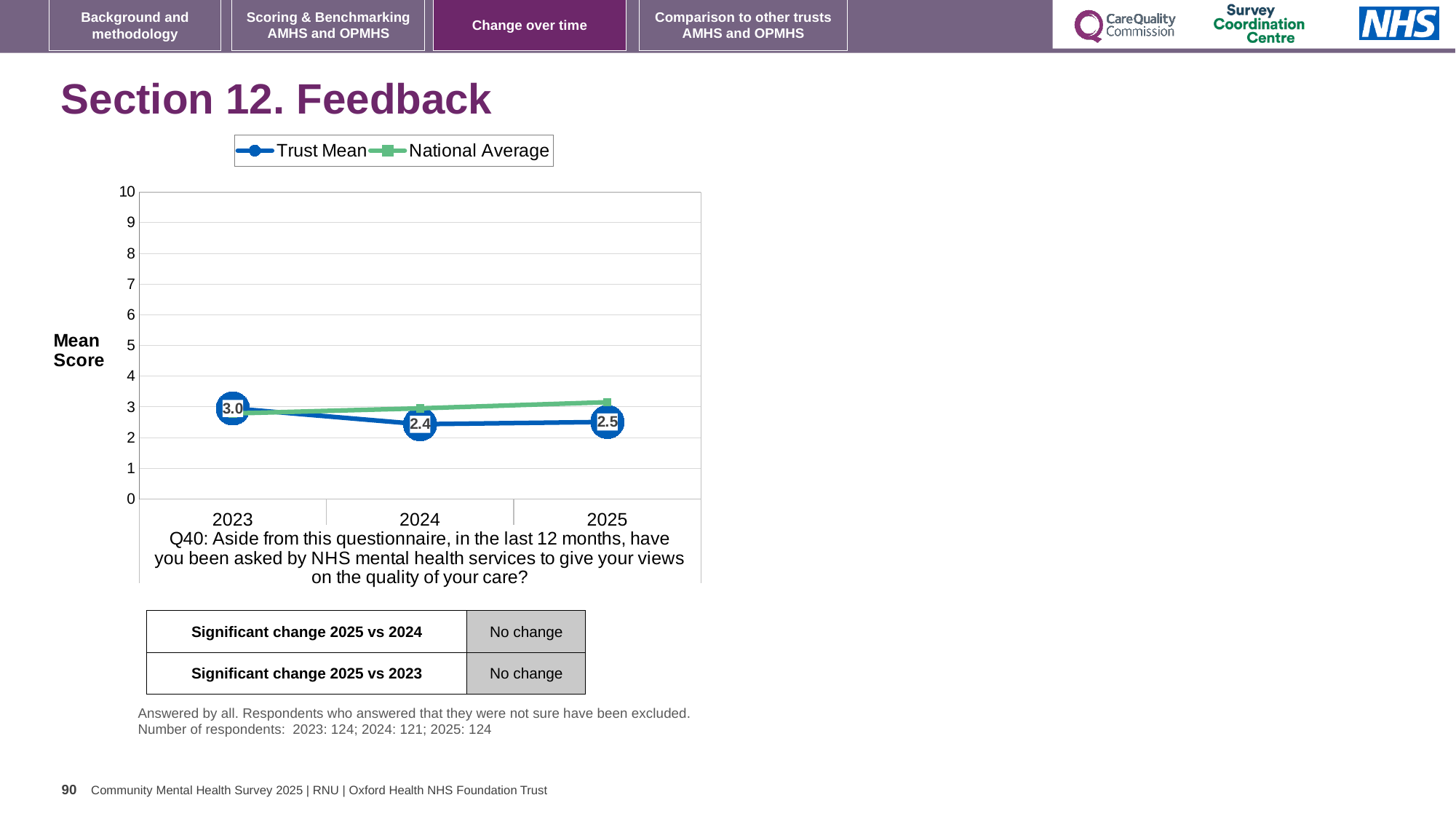
What is the Trust Mean score for 2023? 3.0 Is the National Average value for 2025 greater or less than 2? greater What kind of chart is shown on the slide? Line chart In which year is the Trust Mean lowest? 2024 Does the Trust Mean rise or fall from 2023 to 2024? fall In which year is the Trust Mean highest? 2023 How many years are shown on the x axis? 3 What is the Trust Mean score for 2025? 2.5 Which is larger, the Trust Mean in 2023 or in 2025? 2023 How many series does the legend list? 2 What is the difference between the Trust Mean in 2023 and in 2024? 0.6 What is the Trust Mean score for 2024? 2.4